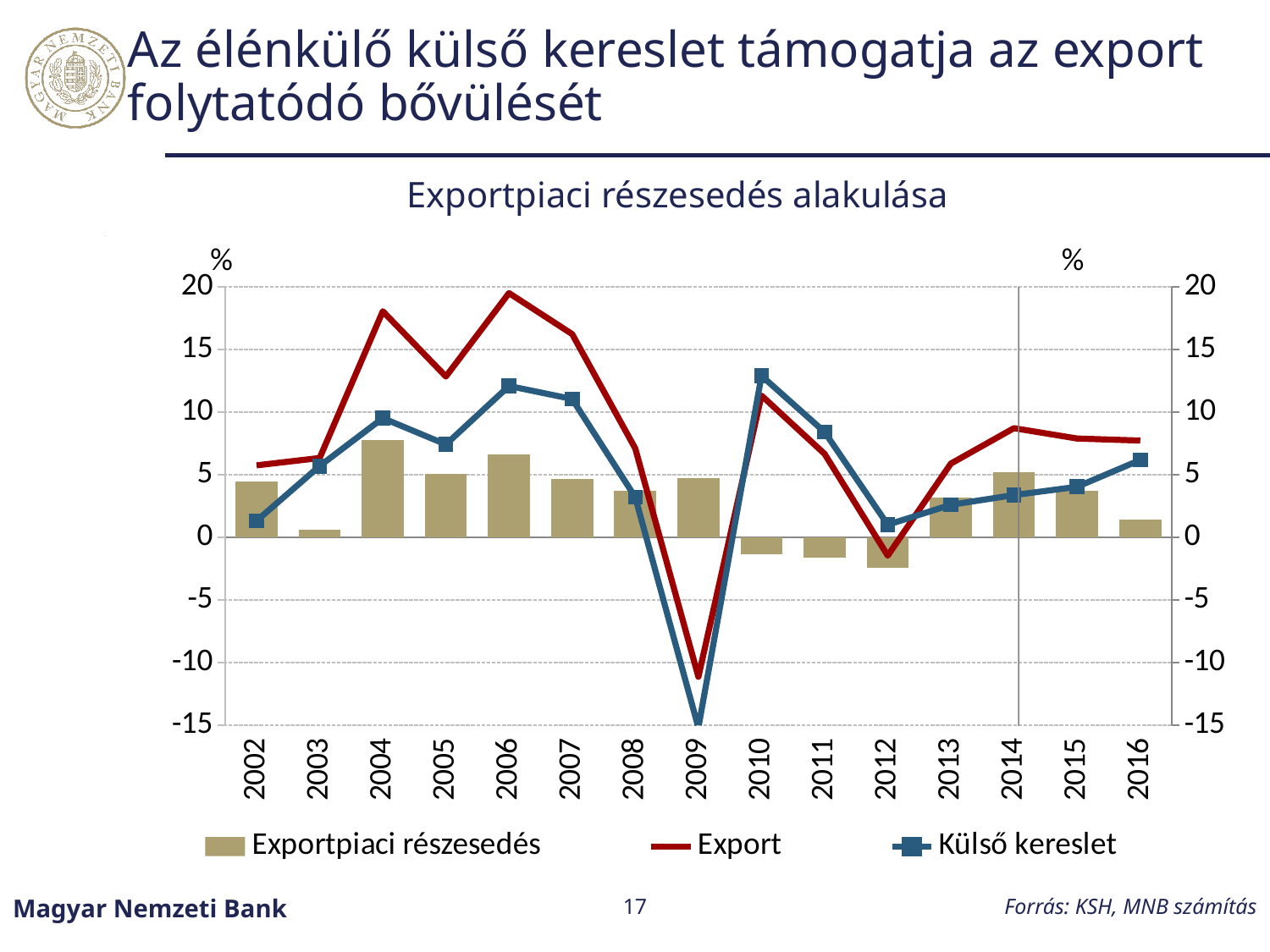
How many series does the legend list? 3 In which year does the Export line reach its lowest value? 2009 Which is larger in 2004, the Export value or the Külső kereslet value? Export Does the Külső kereslet line rise or fall from 2012 to 2016? rise Is the Export value for 2004 greater or less than 15? greater What is the title of the chart? Exportpiaci részesedés alakulása In which year is the Exportpiaci részesedés bar the tallest? 2004 In which year is the Külső kereslet line at its lowest? 2009 In which year does the Export line reach its highest value? 2006 What kind of chart is shown on the slide? A combined bar and line chart How many years are shown on the x axis? 15 Is the Export value for 2009 greater or less than -10? less